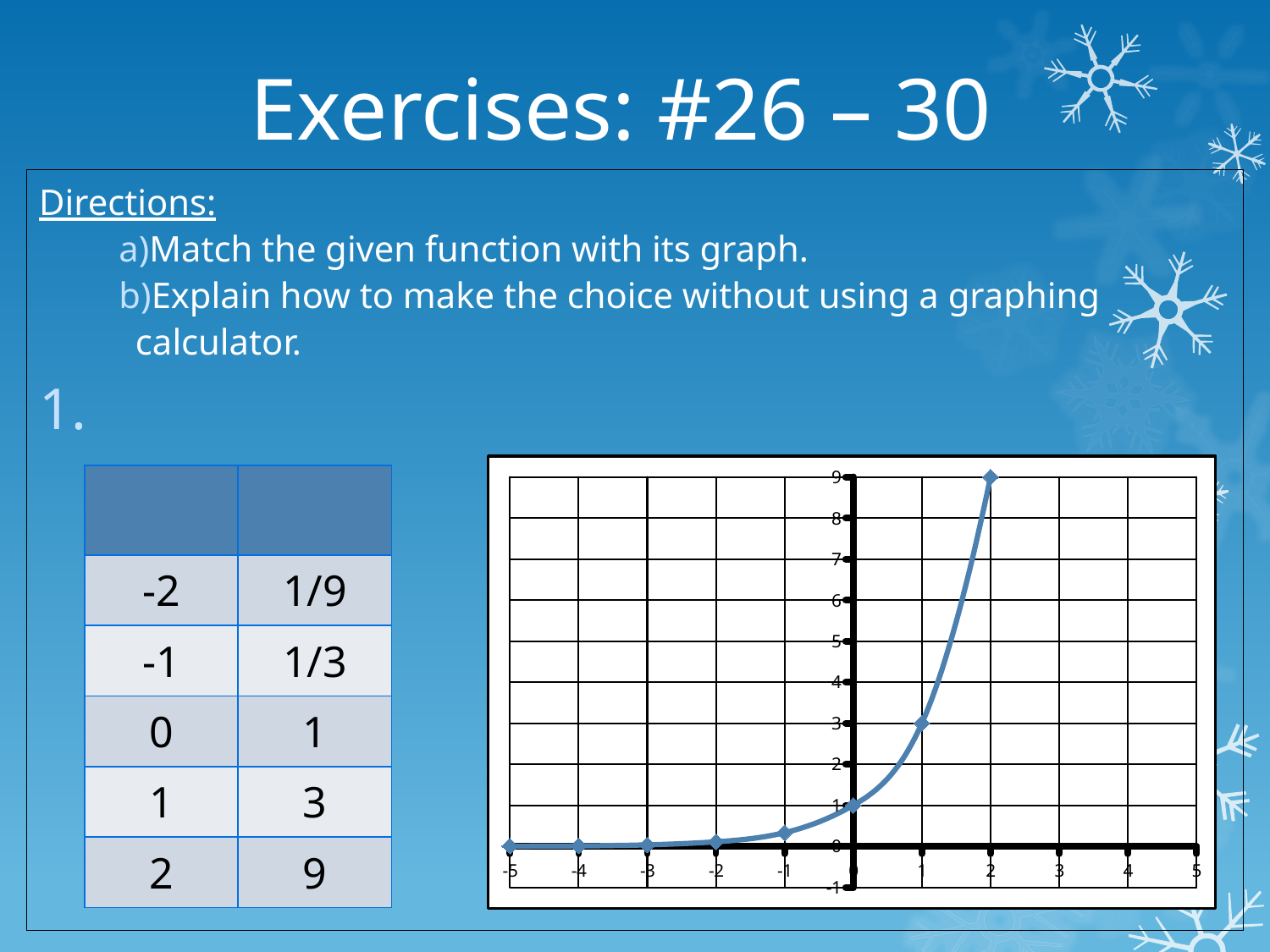
What is the highest value labelled on the y axis of the chart? 9 What is the y value of the plotted point at x = 1? 3 What is the difference between the y values at x = 2 and x = 1? 6 What is the y value of the plotted point at x = 0? 1 At which x value does the plotted curve reach its highest point? 2 What is the y value of the plotted point at x = 2? 9 Is the y value of the point at x = 2 greater or less than 8? greater Is the y value of the point at x = -1 greater or less than 1? less Which has the larger y value, the point at x = 1 or the point at x = 2? x = 2 What kind of chart is shown on the slide? line chart Do the y values rise or fall as x increases along the x axis? rise How many data points are marked on the curve? 8